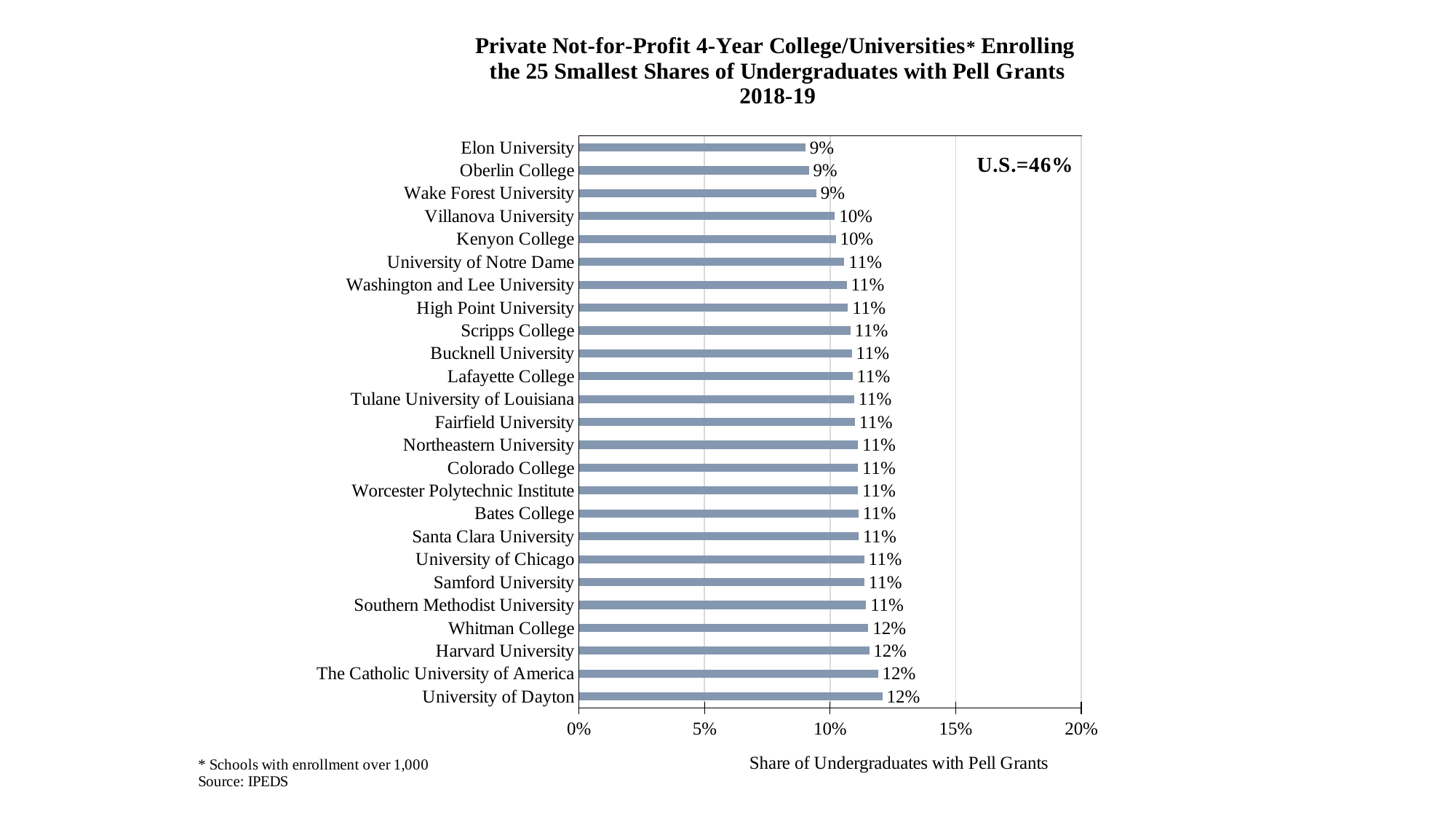
What is the difference between the values for University of Dayton and Elon University? 3% What share of undergraduates with Pell Grants is shown for Harvard University? 12% What U.S. value is noted on the chart for comparison? 46% Which has a larger share of undergraduates with Pell Grants, Harvard University or Oberlin College? Harvard University What is the share of undergraduates with Pell Grants at Elon University? 9% What kind of chart is shown on the slide? Bar chart What is the value shown for Northeastern University? 11% How many colleges/universities are listed in the chart? 25 Is the value for University of Chicago greater or less than 15%? less What is the value shown for University of Dayton? 12% What is the label of the horizontal axis? Share of Undergraduates with Pell Grants What is the value shown for Villanova University? 10%